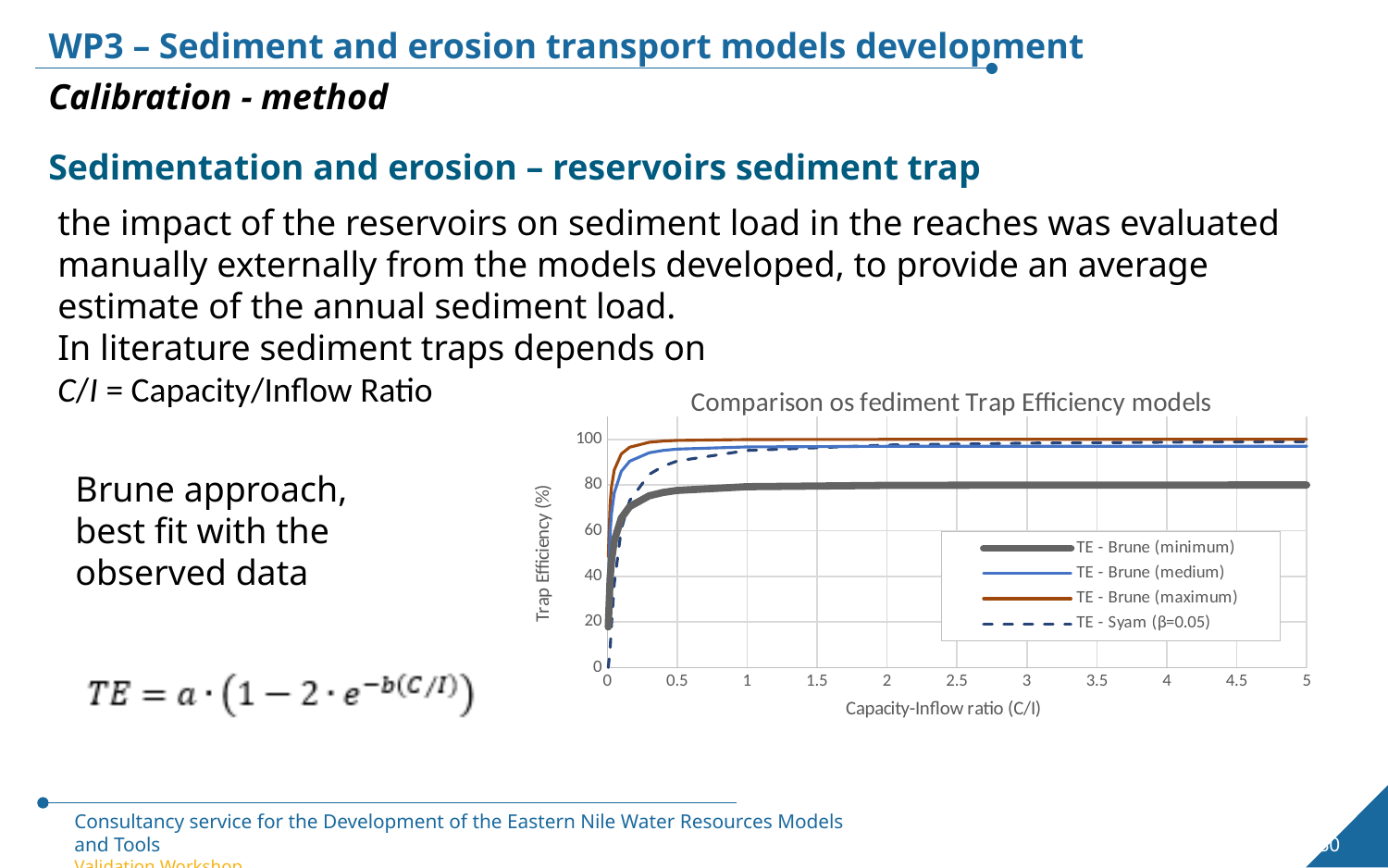
What is the label of the x axis of the chart? Capacity-Inflow ratio (C/I) What is the title of the chart? Comparison os fediment Trap Efficiency models Is the value for TE - Brune (minimum) at a C/I of 1 greater or less than 60? greater Which series has the highest trap efficiency at a C/I of 5? TE - Brune (maximum) At a C/I of 0.5, which is larger: TE - Brune (maximum) or TE - Syam (β=0.05)? TE - Brune (maximum) How many series does the legend of the chart list? 4 Is the value for TE - Brune (medium) at a C/I of 3 greater or less than 80? greater At a C/I of 2, which is larger: TE - Brune (medium) or TE - Brune (minimum)? TE - Brune (medium) What kind of chart is shown on the slide? line chart Is the value for TE - Brune (maximum) at a C/I of 1 greater or less than 80? greater Do the trap efficiency values rise or fall as the Capacity-Inflow ratio increases? rise